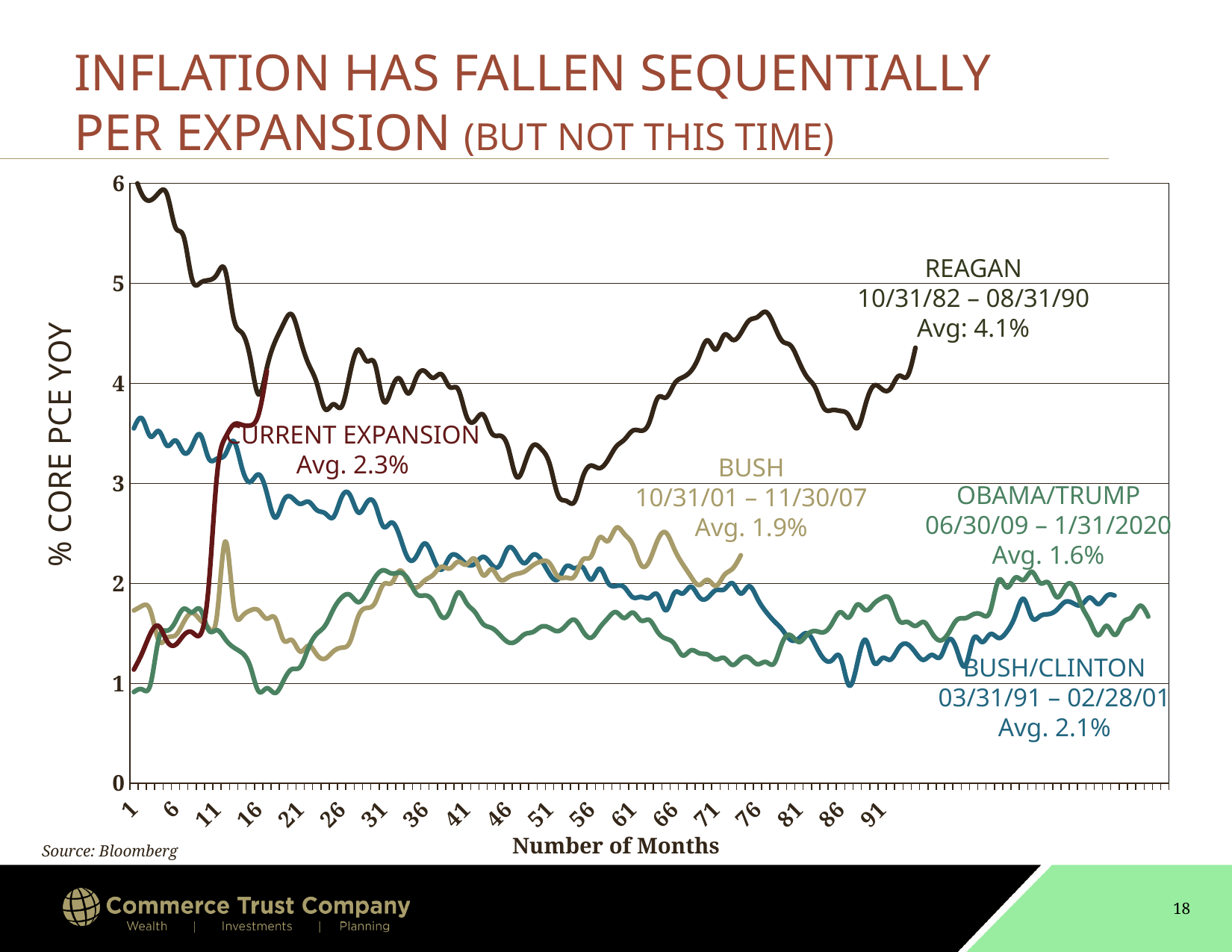
Which has the larger average core PCE inflation, the Bush/Clinton expansion or the Bush expansion? Bush/Clinton Is the Reagan line at month 1 greater or less than 5? greater What is the difference between the Reagan average (4.1%) and the Obama/Trump average (1.6%)? 2.5% What kind of chart is shown on the slide? line chart What is the average core PCE inflation shown for the current expansion? 2.3% How many expansions are plotted as lines on the chart? 5 What is the title of the x axis? Number of Months What is the average core PCE inflation shown for the Obama/Trump expansion? 1.6% Which expansion has the lowest average core PCE inflation? Obama/Trump Which expansion has the highest average core PCE inflation? Reagan What is the average core PCE inflation shown for the Reagan expansion? 4.1% What date range is given for the Bush expansion? 10/31/01 – 11/30/07